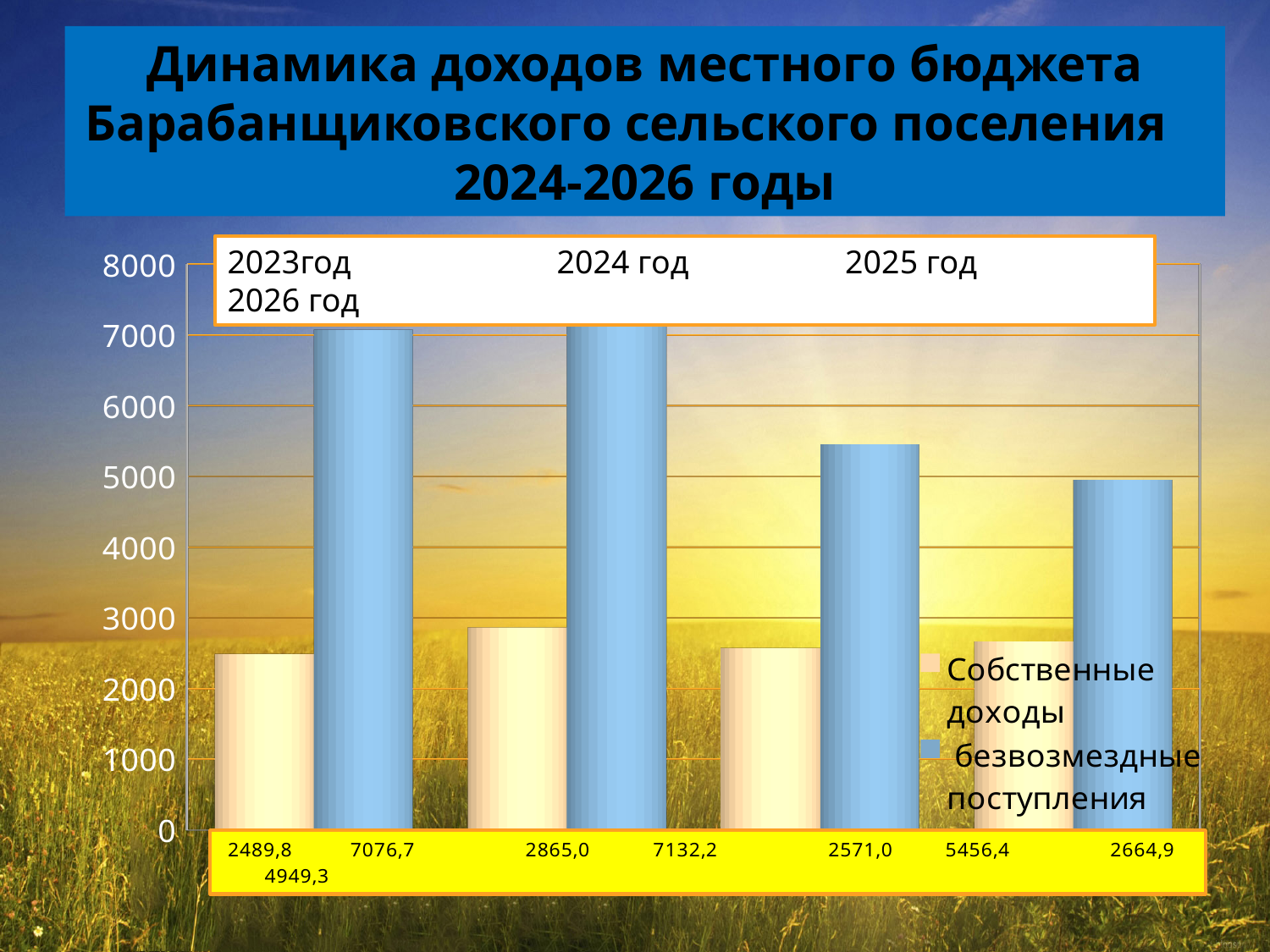
In which year is Собственные доходы highest? 2024 год What is the value of Собственные доходы for 2023 год? 2489,8 Do the values of безвозмездные поступления rise or fall from 2024 год to 2026 год? fall In which year is безвозмездные поступления lowest? 2026 год Which is larger in 2025 год: Собственные доходы or безвозмездные поступления? безвозмездные поступления What is the value of безвозмездные поступления for 2026 год? 4949,3 Is the value of безвозмездные поступления for 2025 год greater or less than 5000? greater What is the value of безвозмездные поступления for 2024 год? 7132,2 What kind of chart is shown on the slide? bar chart How many years are shown on the chart? 4 How many series does the legend list? 2 What is the difference between безвозмездные поступления and Собственные доходы in 2024 год? 4267,2